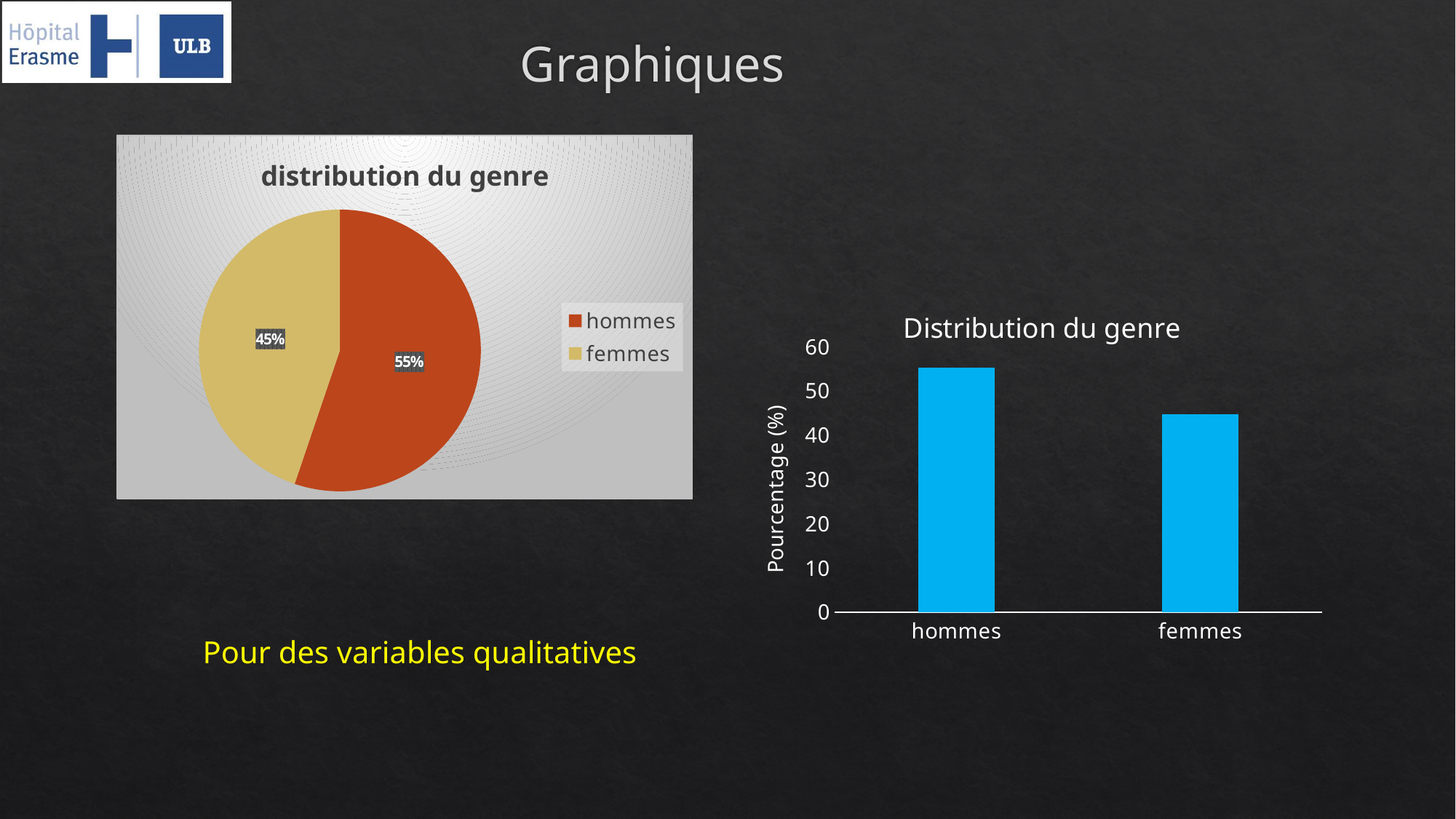
In the bar chart on the right, what is the label of the vertical axis? Pourcentage (%) In the bar chart on the right, is the value for femmes greater or less than 50? less In the pie chart on the left, what share is labelled for femmes? 45% What kind of chart is the chart on the left of the slide? pie chart In the bar chart on the right, is the value for hommes greater or less than 50? greater In the pie chart on the left, which category has the smaller slice? femmes In the pie chart on the left, what is the difference in percentage points between the hommes and femmes slices? 10 In the pie chart on the left, what share is labelled for hommes? 55% In the pie chart on the left, which category has the larger slice? hommes In the pie chart on the left, how many slices are there? 2 In the pie chart on the left, how many entries does the legend list? 2 What kind of chart is the chart on the right of the slide? bar chart